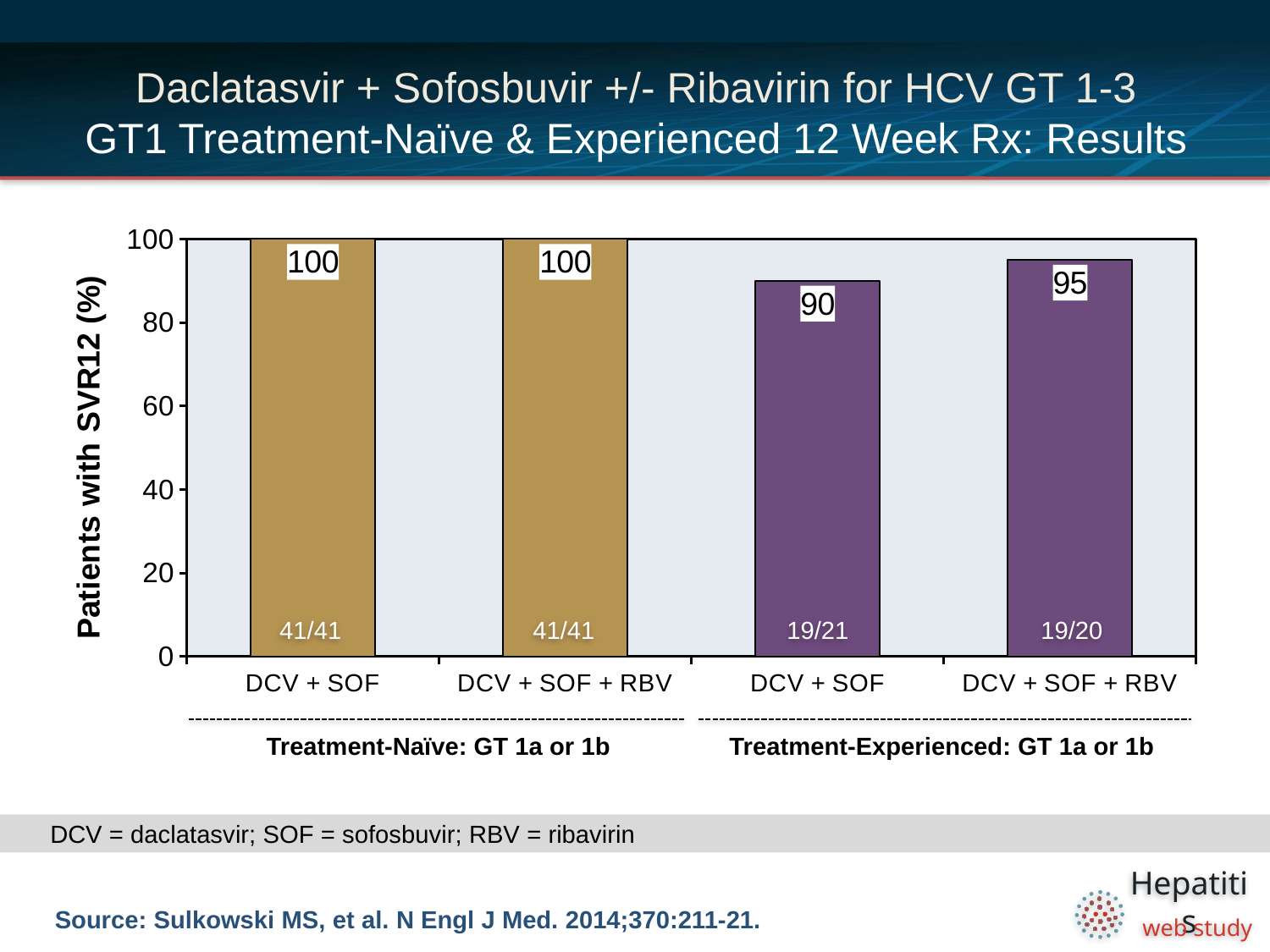
What is the difference in SVR12 rate between DCV + SOF in the Treatment-Naïve group and DCV + SOF in the Treatment-Experienced group? 10 What is the label of the y-axis? Patients with SVR12 (%) Which is larger: the SVR12 rate for DCV + SOF in the Treatment-Naïve group or in the Treatment-Experienced group? Treatment-Naïve What type of chart is shown? Bar chart Which bar has the lowest SVR12 rate? DCV + SOF (Treatment-Experienced) What fraction of patients is shown for DCV + SOF in the Treatment-Experienced group? 19/21 What is the difference in SVR12 rate between DCV + SOF + RBV and DCV + SOF in the Treatment-Experienced group? 5 What is the SVR12 rate for DCV + SOF in the Treatment-Naïve group? 100 What is the SVR12 rate for DCV + SOF in the Treatment-Experienced group? 90 What is the SVR12 rate for DCV + SOF + RBV in the Treatment-Experienced group? 95 How many bars are shown in the chart? 4 What fraction of patients is shown for DCV + SOF + RBV in the Treatment-Naïve group? 41/41